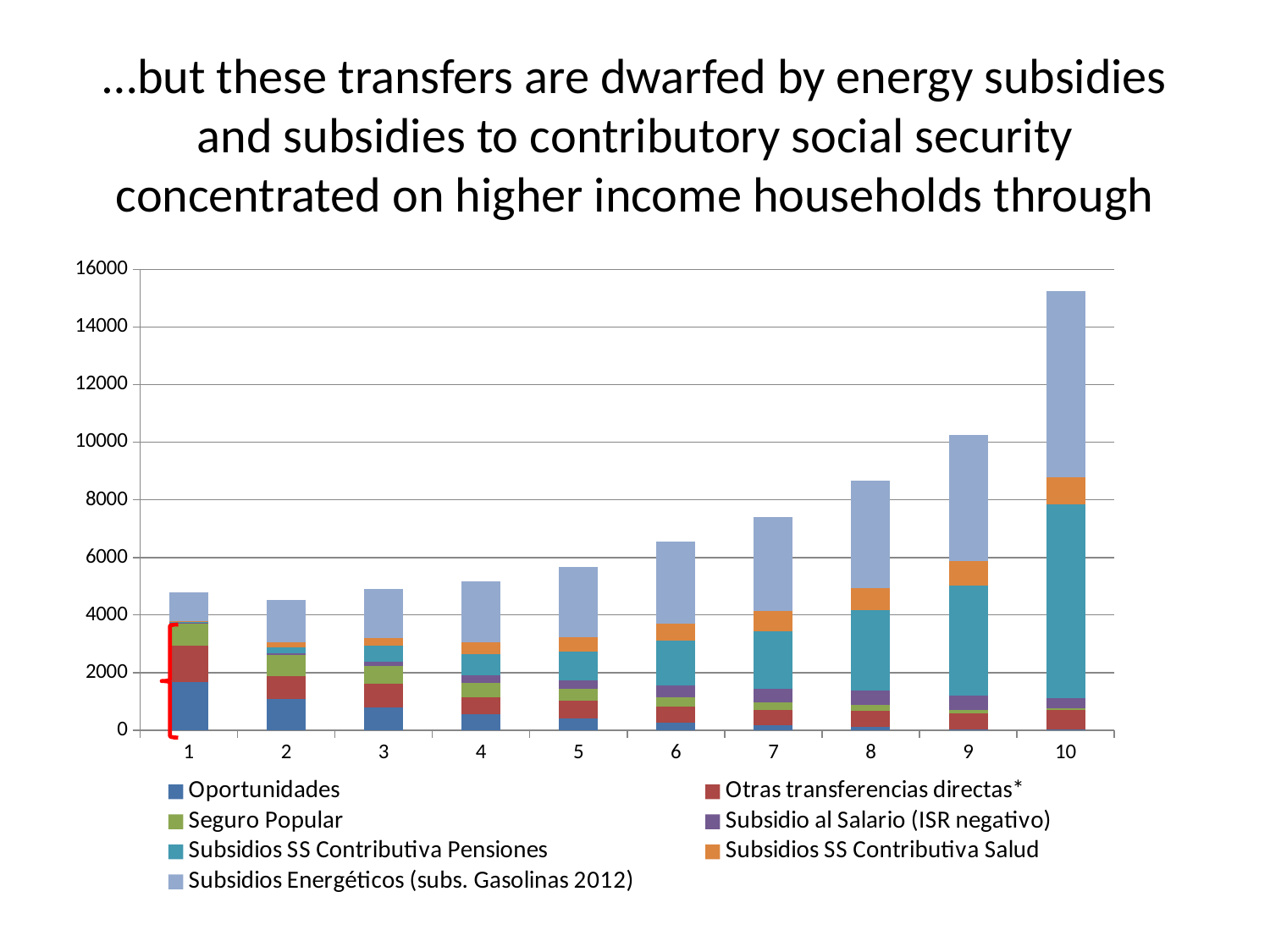
Is the total for category 8 greater or less than 8000? greater Is the total for category 10 greater or less than 14000? greater Which legend entry is shown in light blue (the topmost segment of each bar)? Subsidios Energéticos (subs. Gasolinas 2012) Which has the larger Oportunidades segment, category 1 or category 10? 1 How many series does the legend list? 7 Is the total for category 1 greater or less than 6000? less Do the total bar heights generally rise or fall from category 1 to category 10? rise How many categories (deciles) are shown along the x axis? 10 Which has the larger total bar, category 10 or category 1? 10 What kind of chart is shown on the slide? Stacked bar chart Which category has the highest total stacked bar? 10